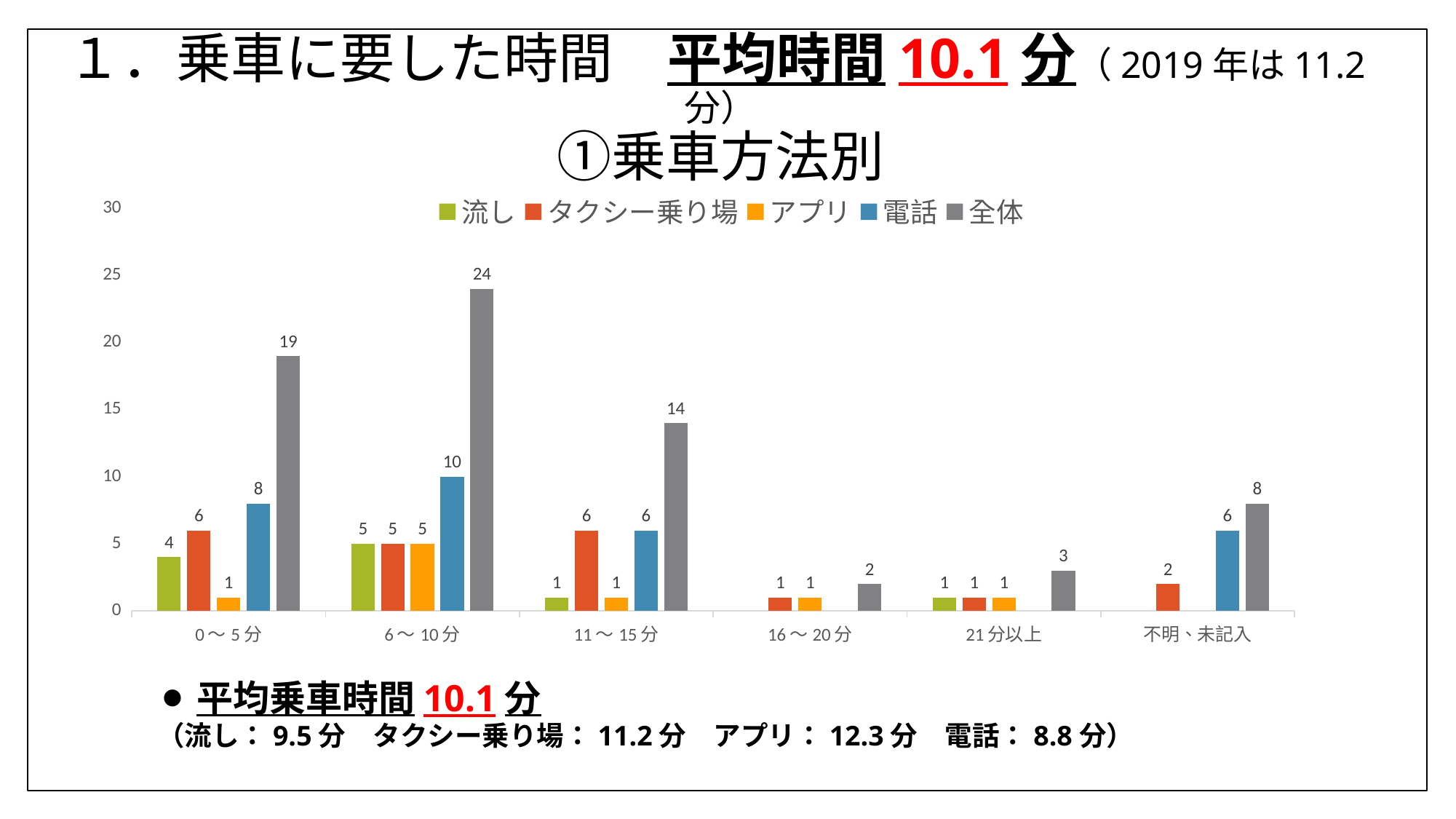
Which is larger: 電話 for 6～10分 or 電話 for 不明、未記入? 電話 for 6～10分 How many categories are shown on the x axis? 6 Which category has the lowest 全体 value? 16～20分 Is the 全体 value for 11～15分 greater or less than 10? greater Which category has the highest 全体 value? 6～10分 What is the value of タクシー乗り場 for the 11～15分 category? 6 What is the difference between the 全体 values for 6～10分 and 0～5分? 5 What is the value of 全体 for the 6～10分 category? 24 What is the value of 電話 for the 0～5分 category? 8 What is the title of the chart? ①乗車方法別 What kind of chart is shown on the slide? bar chart How many series does the legend list? 5